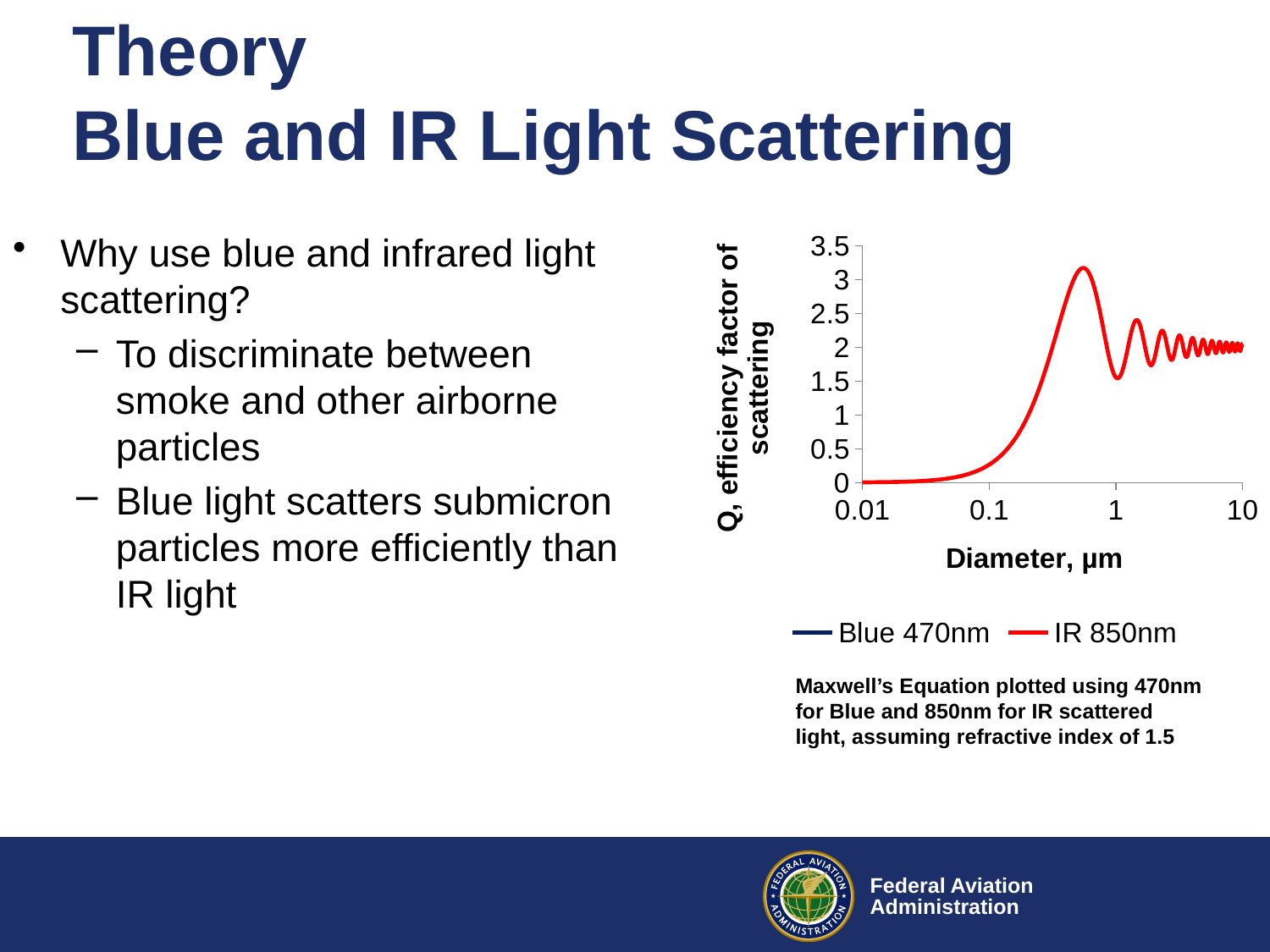
What is the highest value shown on the y axis of the chart? 3.5 How many series does the chart legend list? 2 Which is larger for the IR 850nm curve: the value at a diameter of 0.1 µm or the peak value near 0.5 µm? the peak value near 0.5 µm Is the peak value of the IR 850nm curve greater or less than 3? greater Does the IR 850nm curve rise or fall as the diameter increases from 0.01 µm to about 0.5 µm? rise What is the largest diameter value labelled on the x axis of the chart? 10 Is the value of the IR 850nm curve at a diameter of 0.1 µm greater or less than 0.5? less What is the title of the x axis of the chart? Diameter, µm What kind of chart is shown on the slide? line chart What colour is the IR 850nm line in the chart? red Is the value of the IR 850nm curve at a diameter of 0.01 µm greater or less than 0.5? less Between which two x-axis tick values does the IR 850nm curve reach its highest point? 0.1 and 1